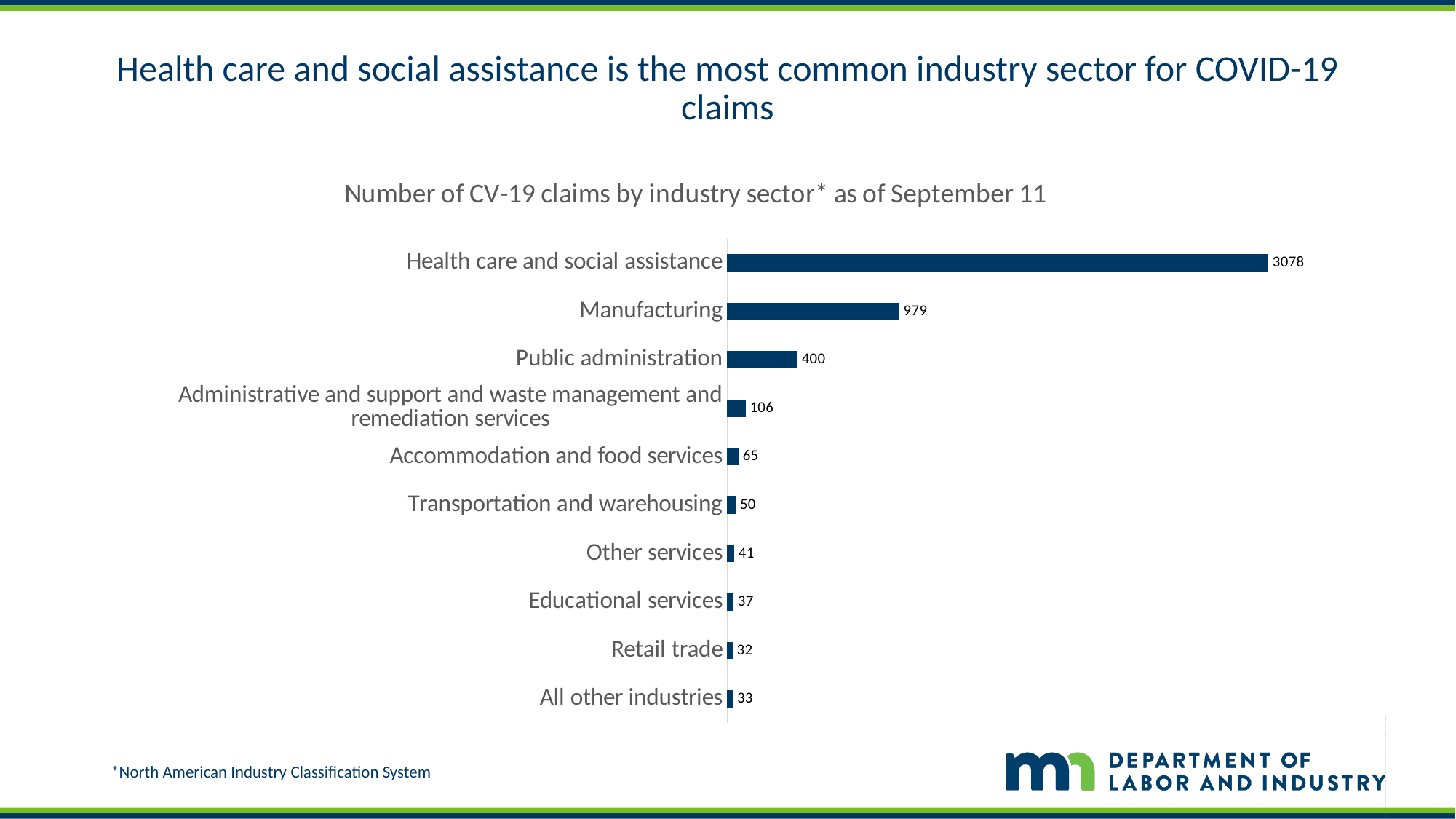
How many claims are shown for Administrative and support and waste management and remediation services? 106 What is the number of claims for Manufacturing? 979 What is the title of the chart? Number of CV-19 claims by industry sector* as of September 11 How many industry sectors are shown in the chart? 10 Which has more claims, Accommodation and food services or Transportation and warehousing? Accommodation and food services What is the difference in claims between Public administration and Administrative and support and waste management and remediation services? 294 How many CV-19 claims are shown for Health care and social assistance? 3078 What is the value shown for Public administration? 400 Which industry sector has the lowest number of claims? Retail trade What is the difference in claims between Health care and social assistance and Manufacturing? 2099 Which industry sector has the highest number of claims? Health care and social assistance What kind of chart is shown on the slide? Bar chart